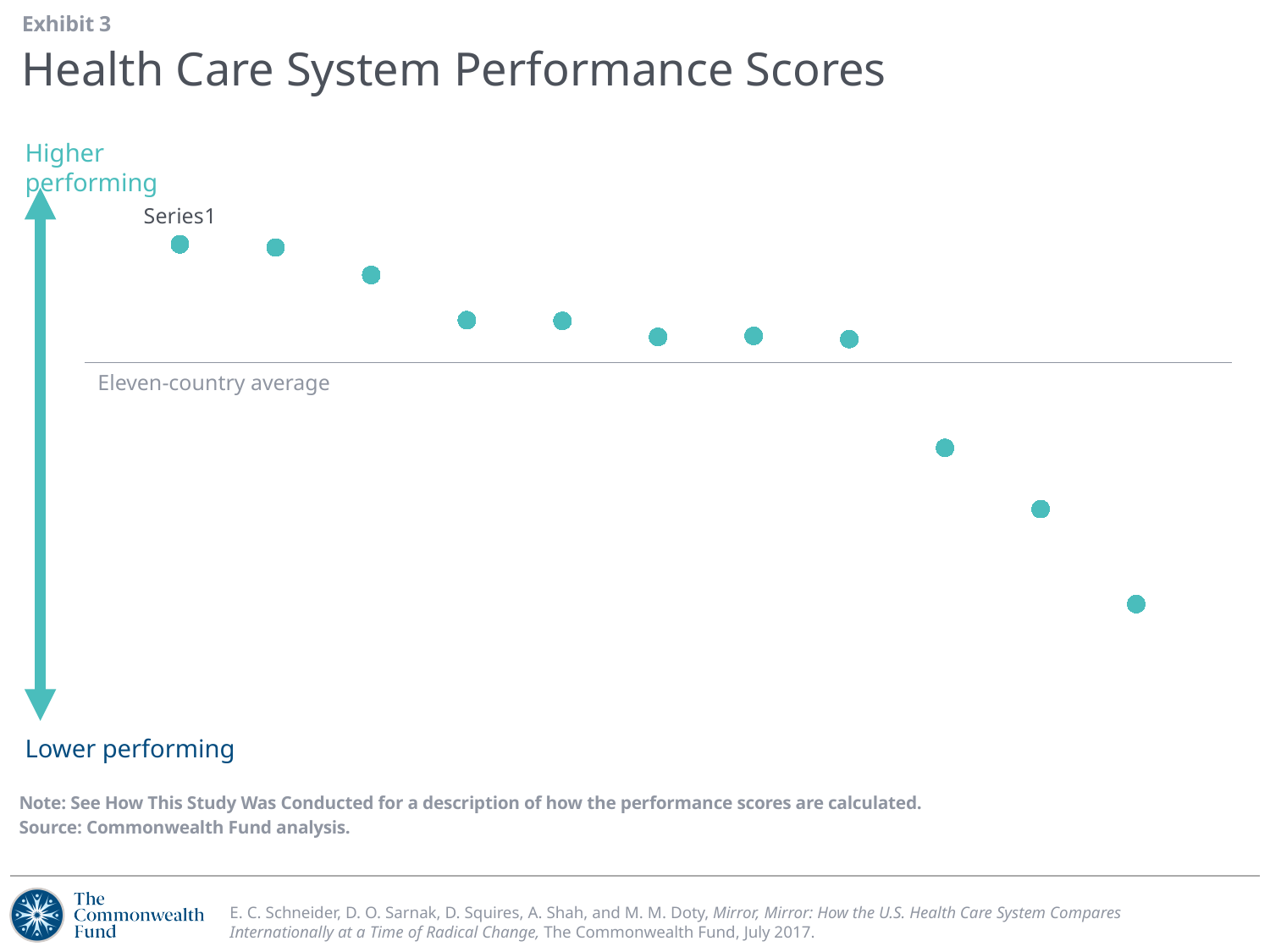
Is the leftmost point above or below the eleven-country average line? Above How many points lie below the eleven-country average line? 3 Which point is higher, the leftmost point or the rightmost point? The leftmost point Is the rightmost point above or below the eleven-country average line? Below How many points lie above the eleven-country average line? 8 Do the plotted values rise or fall from left to right along the x axis? Fall How many series does the chart show? 1 How many data points are plotted on the chart? 11 What is the title of the chart? Health Care System Performance Scores What does the horizontal reference line on the chart represent? Eleven-country average What is the name of the series shown on the chart? Series1 What kind of chart is shown on the slide? Scatter (dot) chart